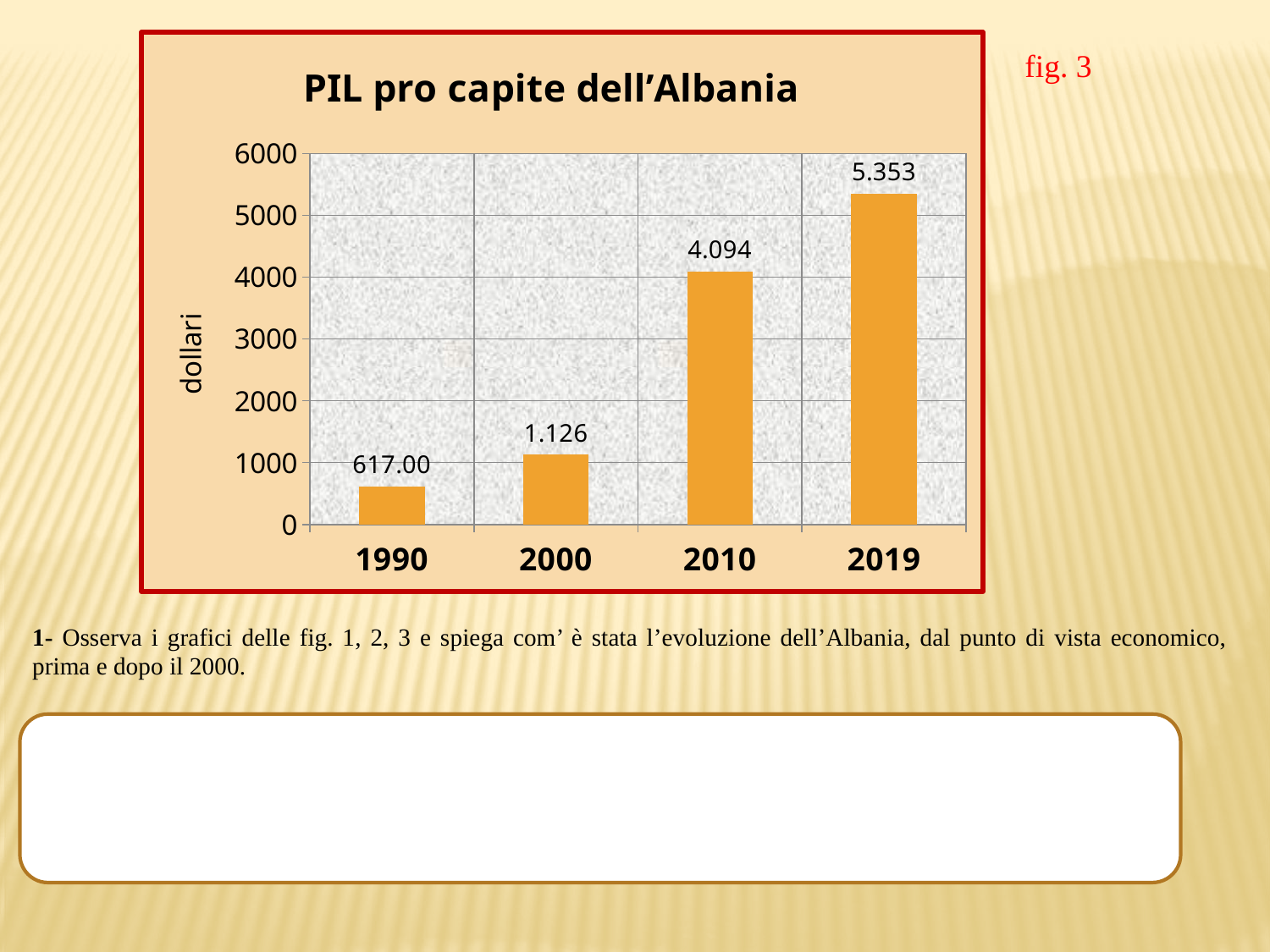
What kind of chart is shown? bar chart What is the PIL pro capite value shown for 2019? 5.353 Is the value for 2019 greater or less than 5000? greater Which is larger, the value for 2000 or the value for 2010? 2010 Which year has the lowest PIL pro capite? 1990 What is the PIL pro capite value shown for 2010? 4.094 What is the PIL pro capite value shown for 2000? 1.126 Do the values rise or fall from 1990 to 2019? rise What is the difference between the values for 2019 and 2010? 1.259 Which year has the highest PIL pro capite? 2019 How many years are shown on the x axis? 4 What is the PIL pro capite value shown for 1990? 617.00